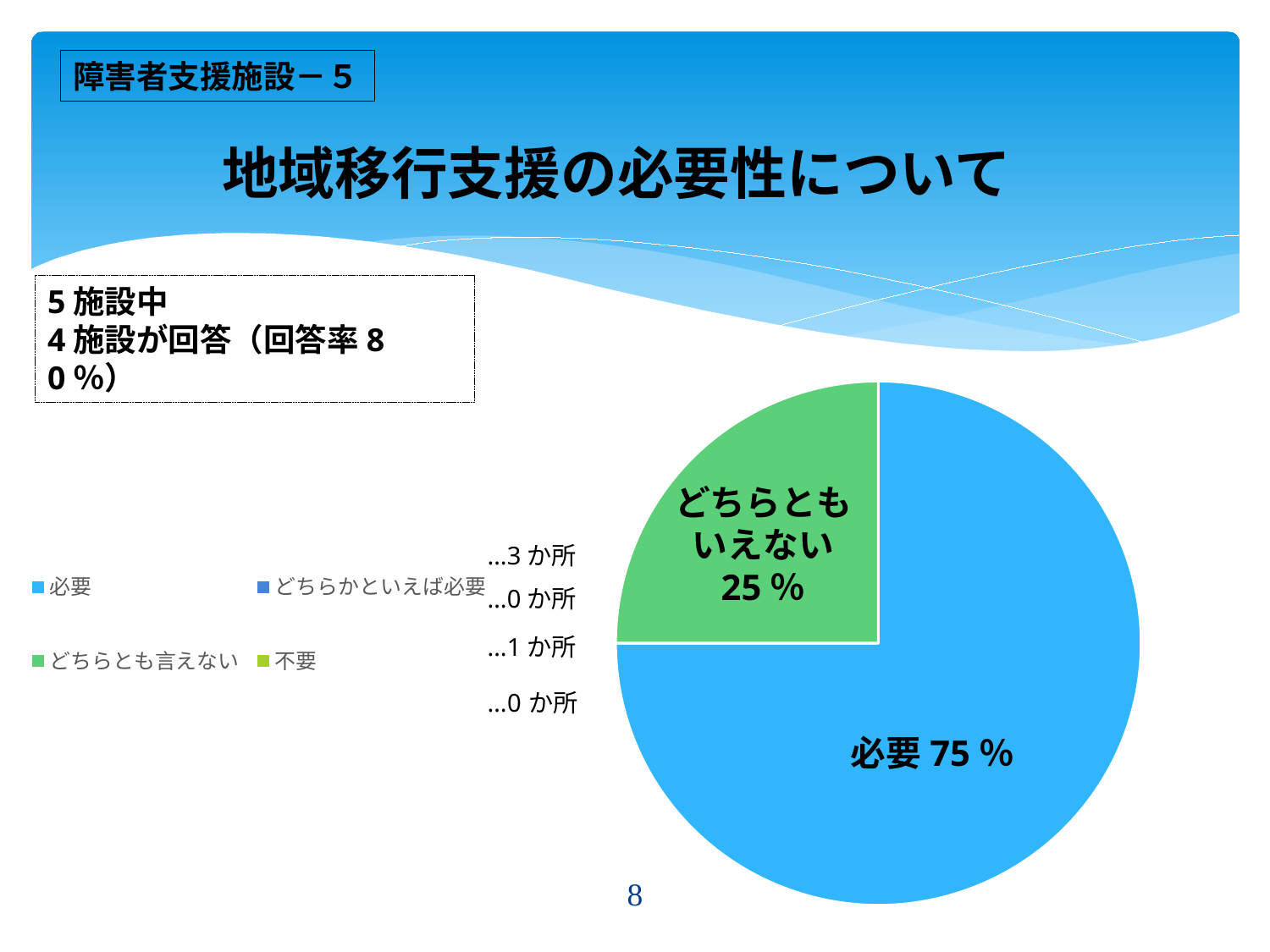
How many slices are visible in the pie? 2 What share of the pie does どちらともいえない take? 25 ％ Which category has the largest slice of the pie? 必要 What is the title of the slide containing the pie chart? 地域移行支援の必要性について How many facilities (か所) answered どちらとも言えない according to the counts next to the legend? 1 か所 How many entries does the legend list? 4 Which of the two labelled slices is larger, 必要 or どちらともいえない? 必要 What is the difference in percentage points between the 必要 slice and the どちらともいえない slice? 50 ％ What kind of chart is shown on the slide? pie chart What colour is the 必要 slice of the pie? blue How many facilities (か所) answered 必要 according to the counts next to the legend? 3 か所 What share of the pie does 必要 take? 75 ％